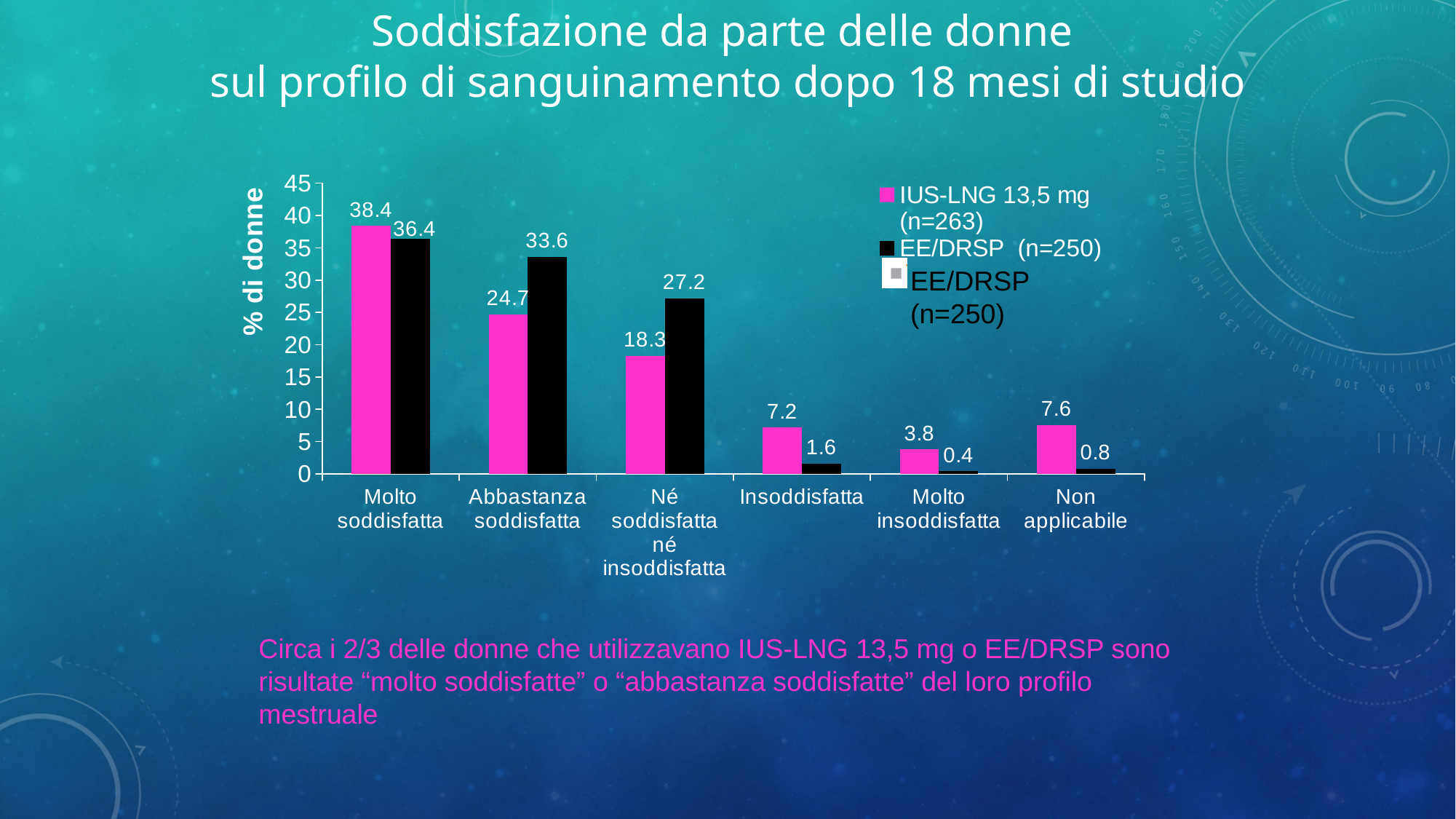
Is the value for EE/DRSP in the "Molto soddisfatta" category greater or less than 30? greater What kind of chart is shown on the slide? Bar chart In the "Insoddisfatta" category, which series has the larger value, IUS-LNG 13,5 mg or EE/DRSP? IUS-LNG 13,5 mg How many categories are shown on the x axis of the chart? 6 What is the difference between the EE/DRSP and IUS-LNG 13,5 mg values in the "Abbastanza soddisfatta" category? 8.9 Which category has the lowest value for EE/DRSP? Molto insoddisfatta What is the value for IUS-LNG 13,5 mg in the "Non applicabile" category? 7.6 Which category has the highest value for IUS-LNG 13,5 mg? Molto soddisfatta What is the value for EE/DRSP in the "Né soddisfatta né insoddisfatta" category? 27.2 What is the value for IUS-LNG 13,5 mg in the "Molto soddisfatta" category? 38.4 What is the value for EE/DRSP in the "Abbastanza soddisfatta" category? 33.6 What is the label of the y axis of the chart? % di donne